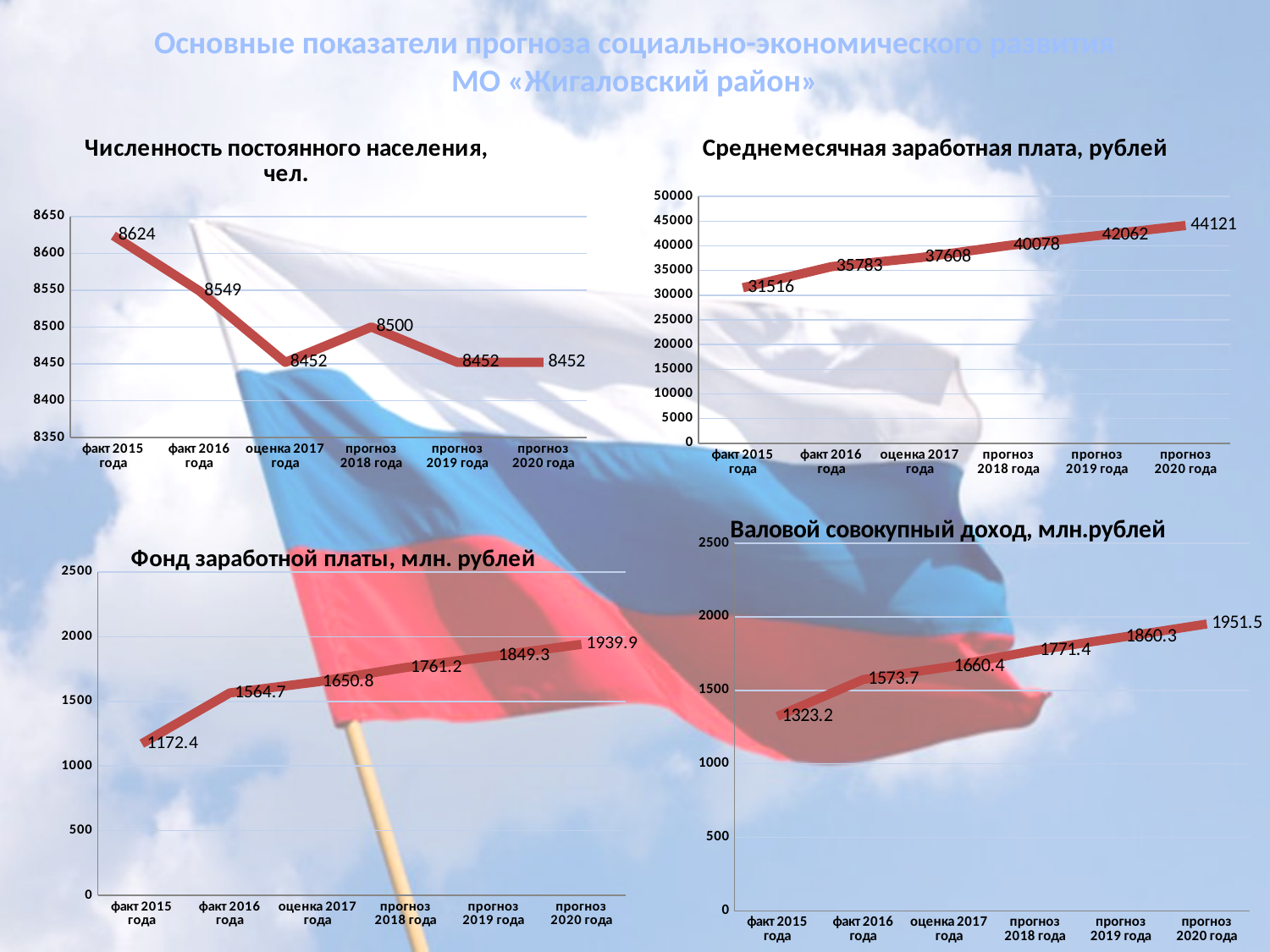
In the chart titled "Фонд заработной платы, млн. рублей", which category has the lowest value? факт 2015 года In the chart titled "Численность постоянного населения, чел.", which category has the highest value? факт 2015 года In the chart titled "Фонд заработной платы, млн. рублей", how many data points are plotted? 6 In the chart titled "Среднемесячная заработная плата, рублей", do the values rise or fall from "факт 2015 года" to "прогноз 2020 года"? rise In the chart titled "Валовой совокупный доход, млн.рублей", what is the value for "оценка 2017 года"? 1660.4 In the chart titled "Численность постоянного населения, чел.", what is the difference between the values for "факт 2015 года" and "факт 2016 года"? 75 What kind of chart is the one titled "Валовой совокупный доход, млн.рублей"? line chart In the chart titled "Среднемесячная заработная плата, рублей", what is the value for "прогноз 2020 года"? 44121 In the chart titled "Валовой совокупный доход, млн.рублей", which is larger: the value for "прогноз 2020 года" or the value for "факт 2016 года"? прогноз 2020 года In the chart titled "Численность постоянного населения, чел.", what is the value for "факт 2015 года"? 8624 In the chart titled "Среднемесячная заработная плата, рублей", what is the difference between the values for "прогноз 2019 года" and "прогноз 2018 года"? 1984 In the chart titled "Фонд заработной платы, млн. рублей", what is the value for "факт 2015 года"? 1172.4